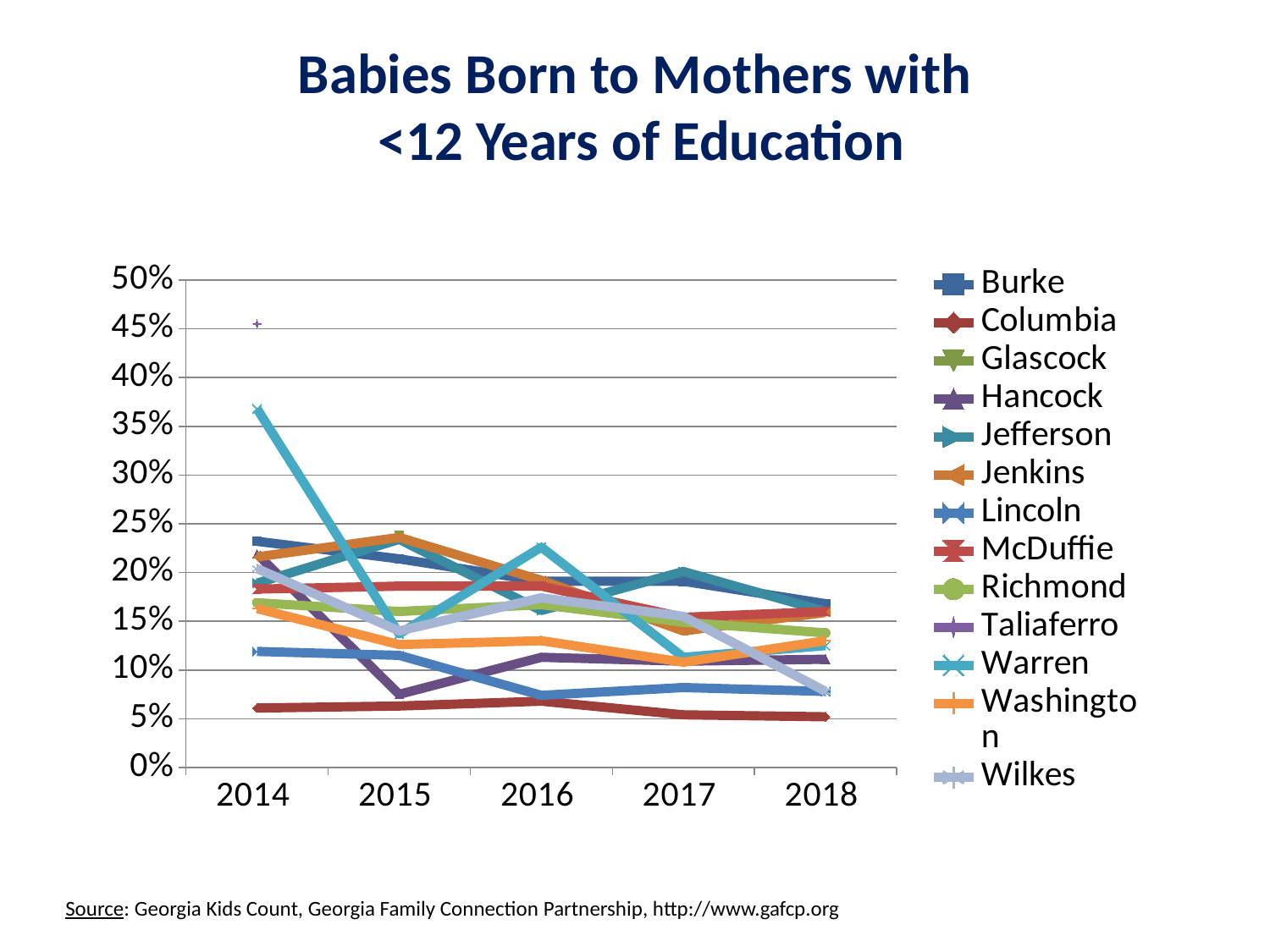
What is the title of the chart? Babies Born to Mothers with <12 Years of Education Which series has the lowest value in 2018? Columbia Is the value for Taliaferro in 2014 greater or less than 40%? greater Does the Burke line rise or fall from 2014 to 2018? fall Is the value for Columbia in 2018 greater or less than 10%? less How many years are shown on the x axis? 5 Is the value for Warren in 2014 greater or less than 30%? greater How many series does the legend list? 13 What kind of chart is shown on the slide? line chart Which is larger for Warren: the value in 2014 or the value in 2015? 2014 Which series has the highest value in 2014? Taliaferro